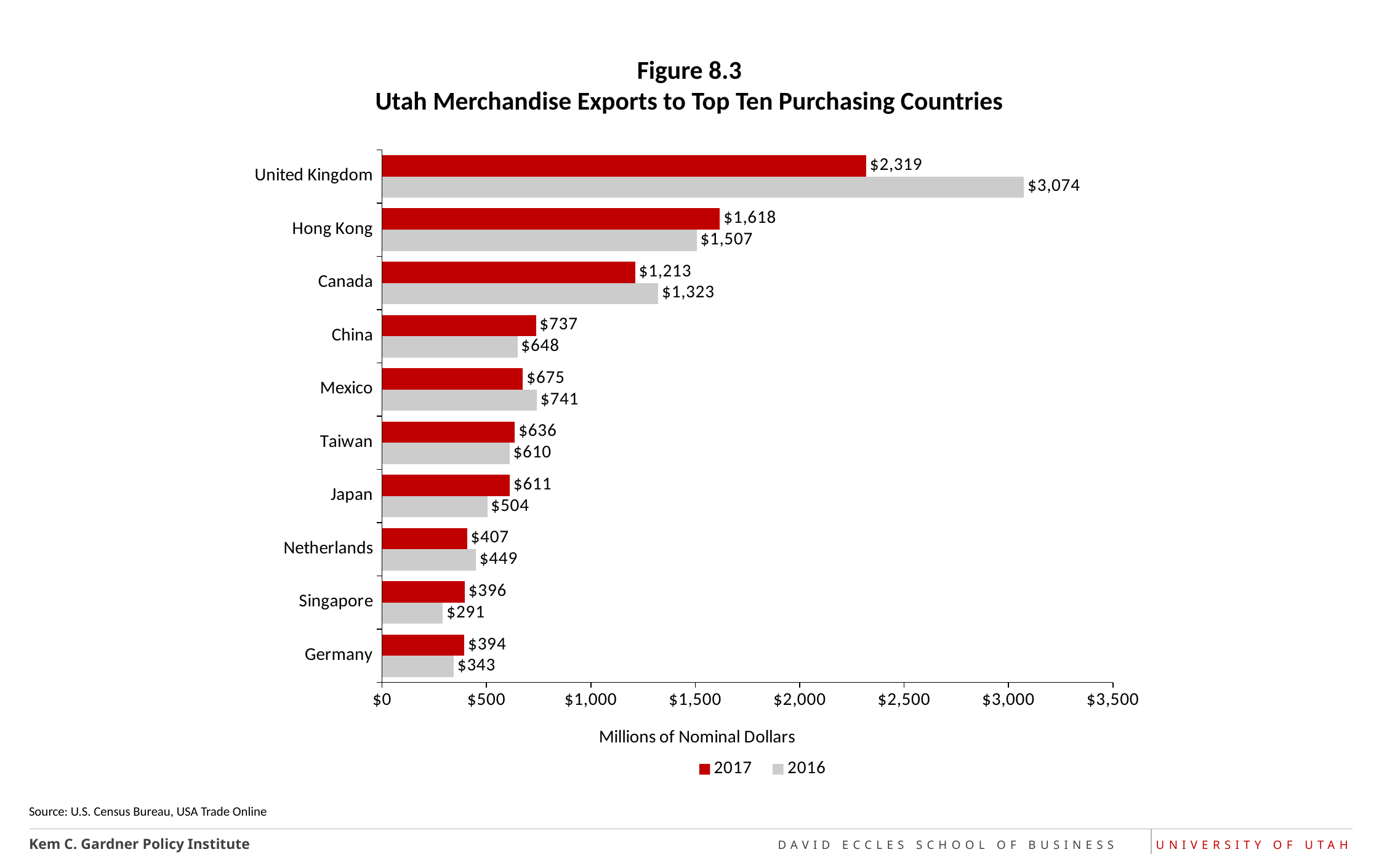
Which country had the lowest value of Utah merchandise exports in 2017? Germany How many countries are shown in the chart? 10 What is the difference between the 2016 and 2017 export values for the United Kingdom? $755 What type of chart is shown on the slide? Bar chart Were Utah's exports to Mexico larger in 2016 or 2017? 2016 Which had a larger 2017 export value, China or Taiwan? China What is the difference between the 2017 and 2016 export values for Hong Kong? $111 What was the value of Utah merchandise exports to Singapore in 2016? $291 How many series does the legend list? 2 What was the value of Utah merchandise exports to Canada in 2016? $1,323 What was the value of Utah merchandise exports to the United Kingdom in 2017? $2,319 Which country had the highest value of Utah merchandise exports in 2016? United Kingdom